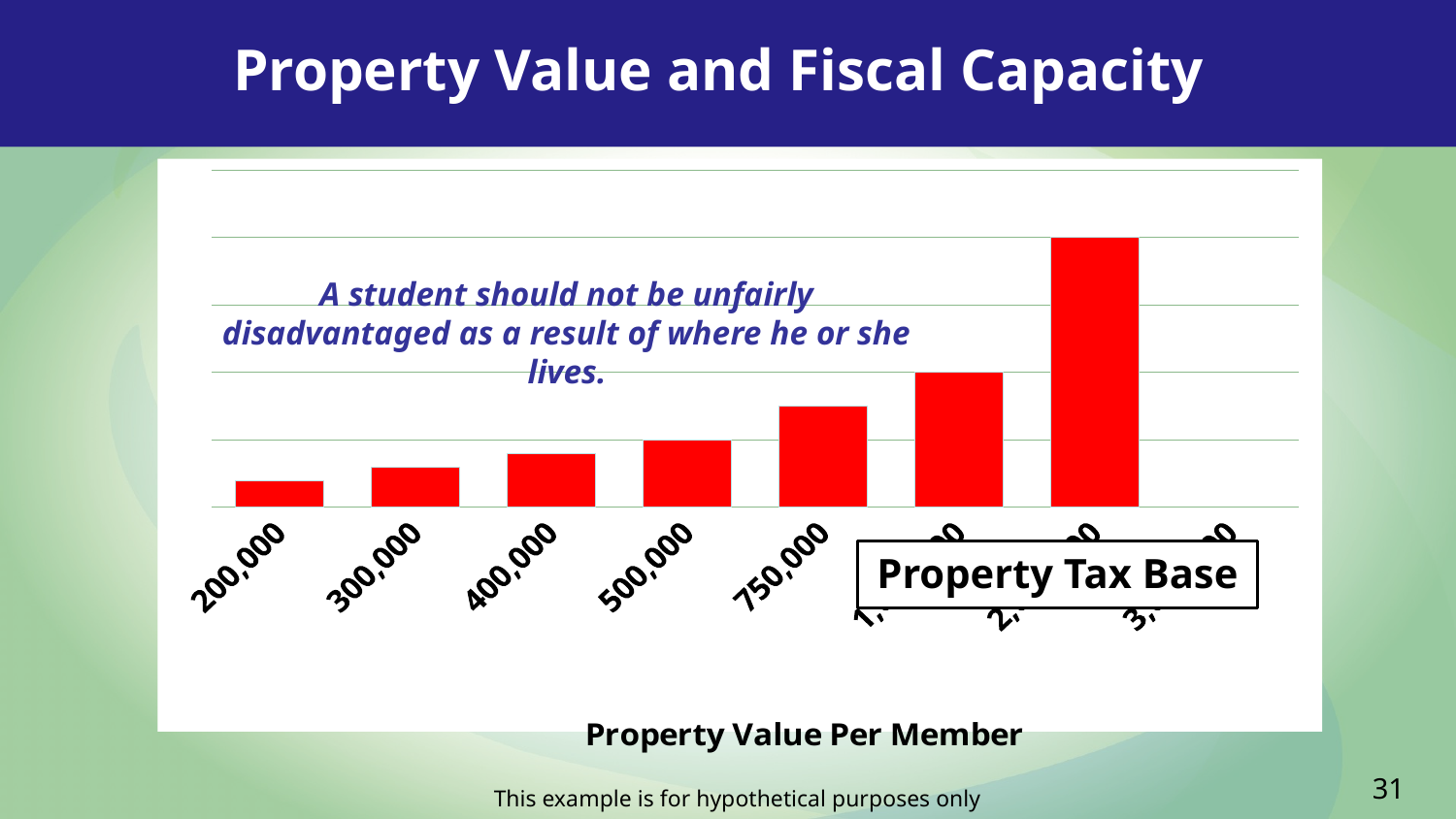
Which has the larger value, 300,000 or 750,000? 750,000 Which bar is the tallest in the chart, by position? the rightmost bar Which has the larger value, 500,000 or 750,000? 750,000 What kind of chart is shown on the slide? bar chart How many bars are plotted in the chart? 7 Which category has the lowest bar in the chart? 200,000 Which has the larger value, 200,000 or 400,000? 400,000 What is the x-axis title of the chart? Property Value Per Member Do the bar values rise or fall moving from left to right along the x axis? rise